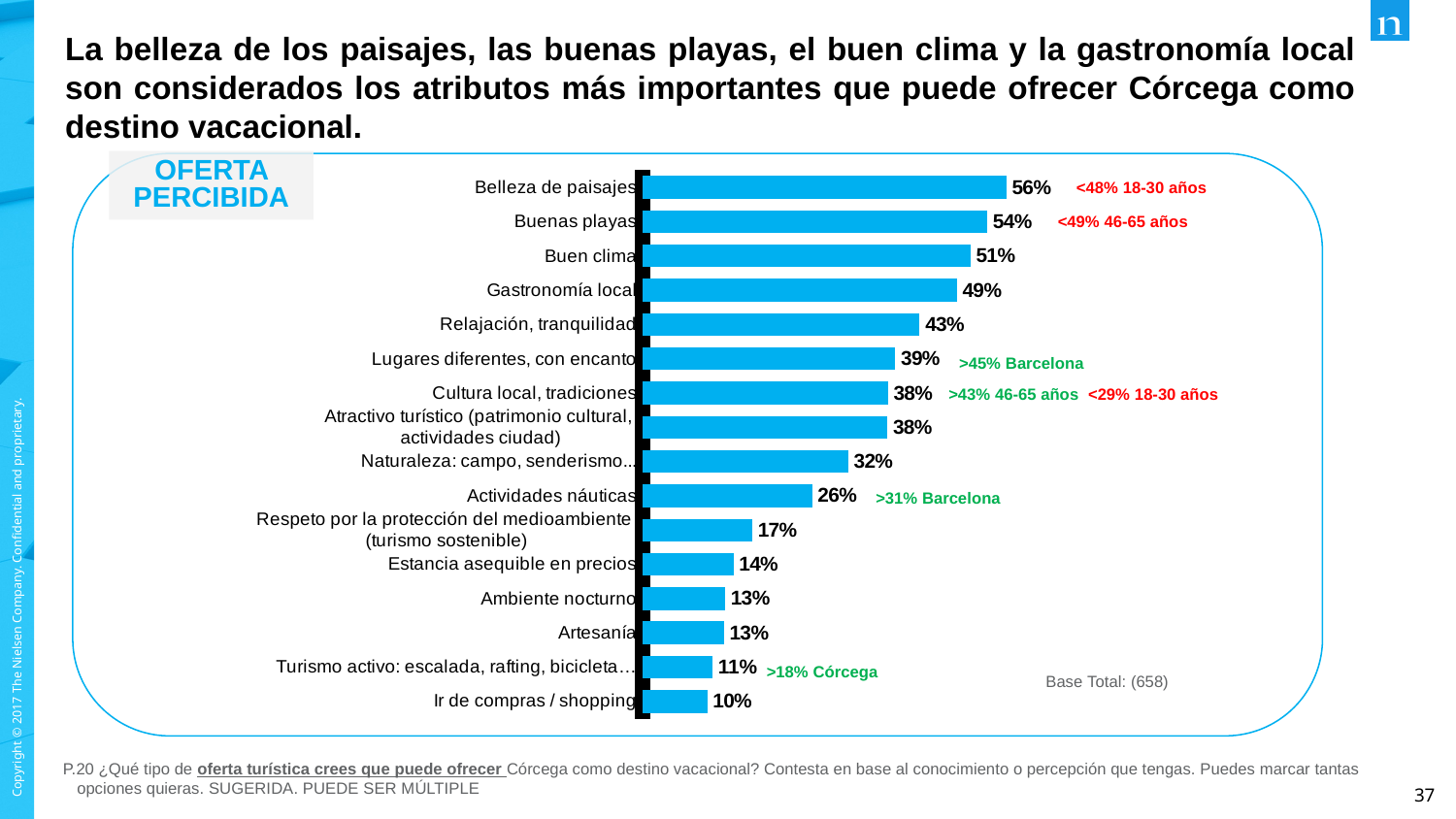
Do the values rise or fall going from the top bar to the bottom bar? Fall What type of chart is shown on the slide? Bar chart What is the value for Estancia asequible en precios? 14% How many categories are shown in the chart? 16 Which is larger, the value for Buen clima or the value for Gastronomía local? Buen clima Which category has the lowest value? Ir de compras / shopping What is the value for Actividades náuticas? 26% Which category has the highest value? Belleza de paisajes What is the base total shown on the chart? 658 What is the difference between the values for Belleza de paisajes and Buenas playas? 2 percentage points What is the value for Belleza de paisajes? 56% What is the value for Gastronomía local? 49%